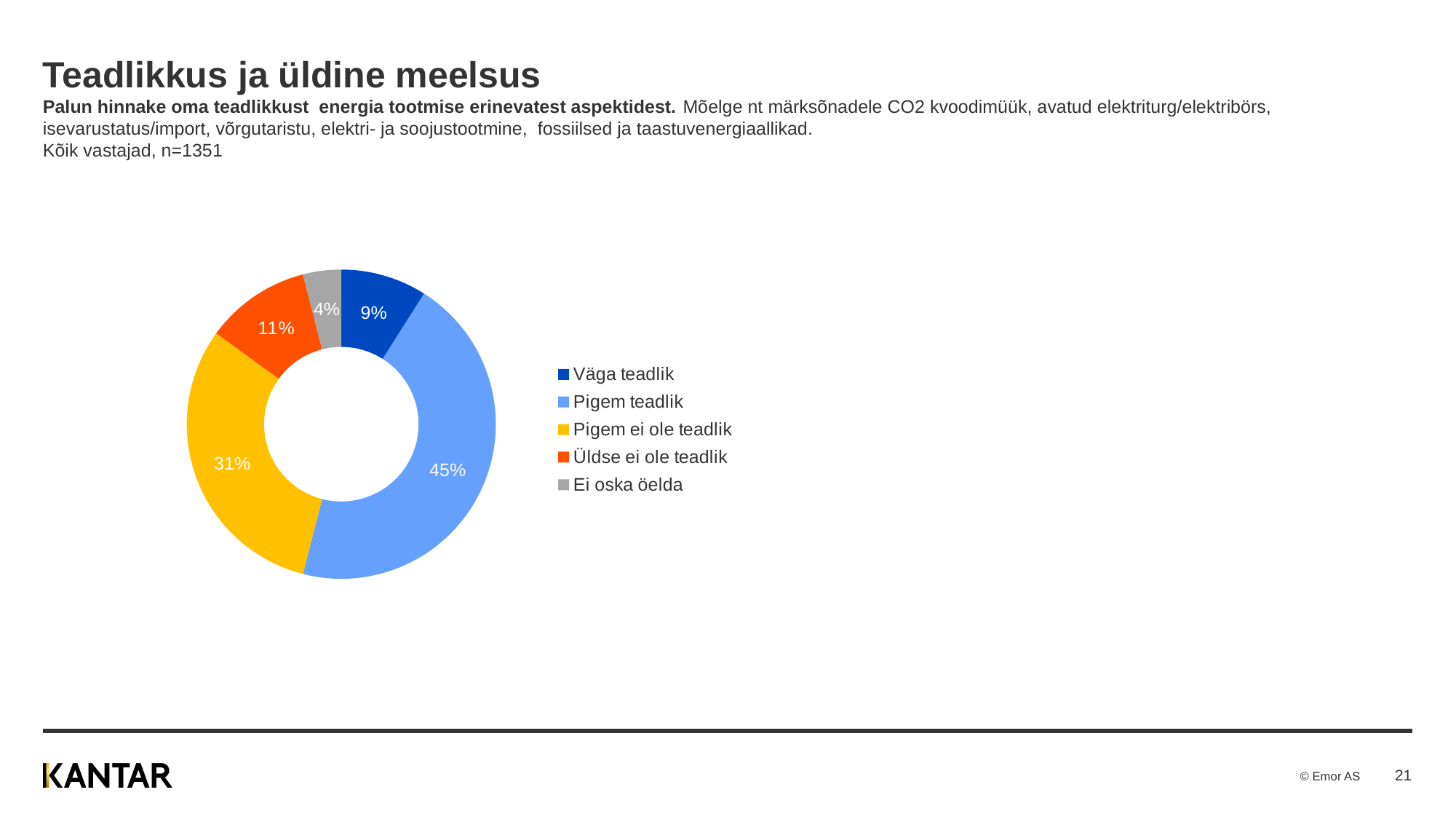
Which category has the smallest share of the chart? Ei oska öelda What share of respondents answered "Väga teadlik"? 9% What share of respondents answered "Ei oska öelda"? 4% What is the difference in percentage points between "Pigem teadlik" and "Pigem ei ole teadlik"? 14 percentage points How many categories does the legend list? 5 What kind of chart is shown on the slide? Doughnut (pie) chart What share of respondents answered "Üldse ei ole teadlik"? 11% What colour is the slice for "Pigem ei ole teadlik"? Yellow What share of respondents answered "Pigem teadlik"? 45% Which is larger, the share for "Väga teadlik" or the share for "Üldse ei ole teadlik"? Üldse ei ole teadlik What share of respondents answered "Pigem ei ole teadlik"? 31% Which category has the largest share of the chart? Pigem teadlik